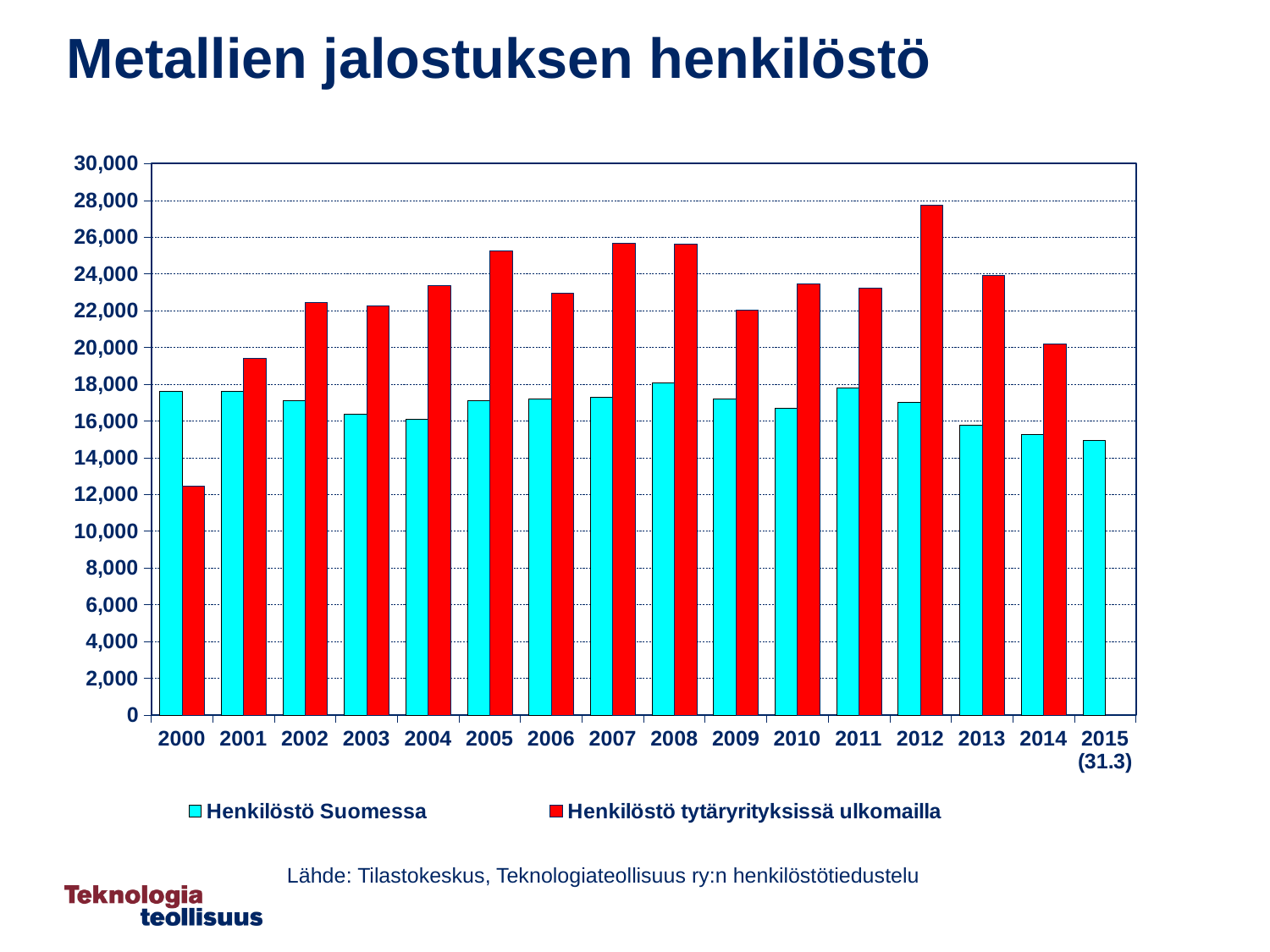
In 2000, which is larger: Henkilöstö Suomessa or Henkilöstö tytäryrityksissä ulkomailla? Henkilöstö Suomessa In which year is the value for Henkilöstö tytäryrityksissä ulkomailla highest? 2012 How many years are shown on the x axis? 16 Does the value for Henkilöstö Suomessa rise or fall from 2012 to 2015 (31.3)? fall In which year is the value for Henkilöstö Suomessa lowest? 2015 (31.3) Is the value for Henkilöstö tytäryrityksissä ulkomailla in 2012 greater or less than 26,000? greater Is the value for Henkilöstö tytäryrityksissä ulkomailla in 2000 greater or less than 14,000? less In which year is the value for Henkilöstö tytäryrityksissä ulkomailla lowest? 2000 How many series does the legend list? 2 Is the value for Henkilöstö tytäryrityksissä ulkomailla in 2005 greater or less than 24,000? greater What kind of chart is shown on the slide? bar chart